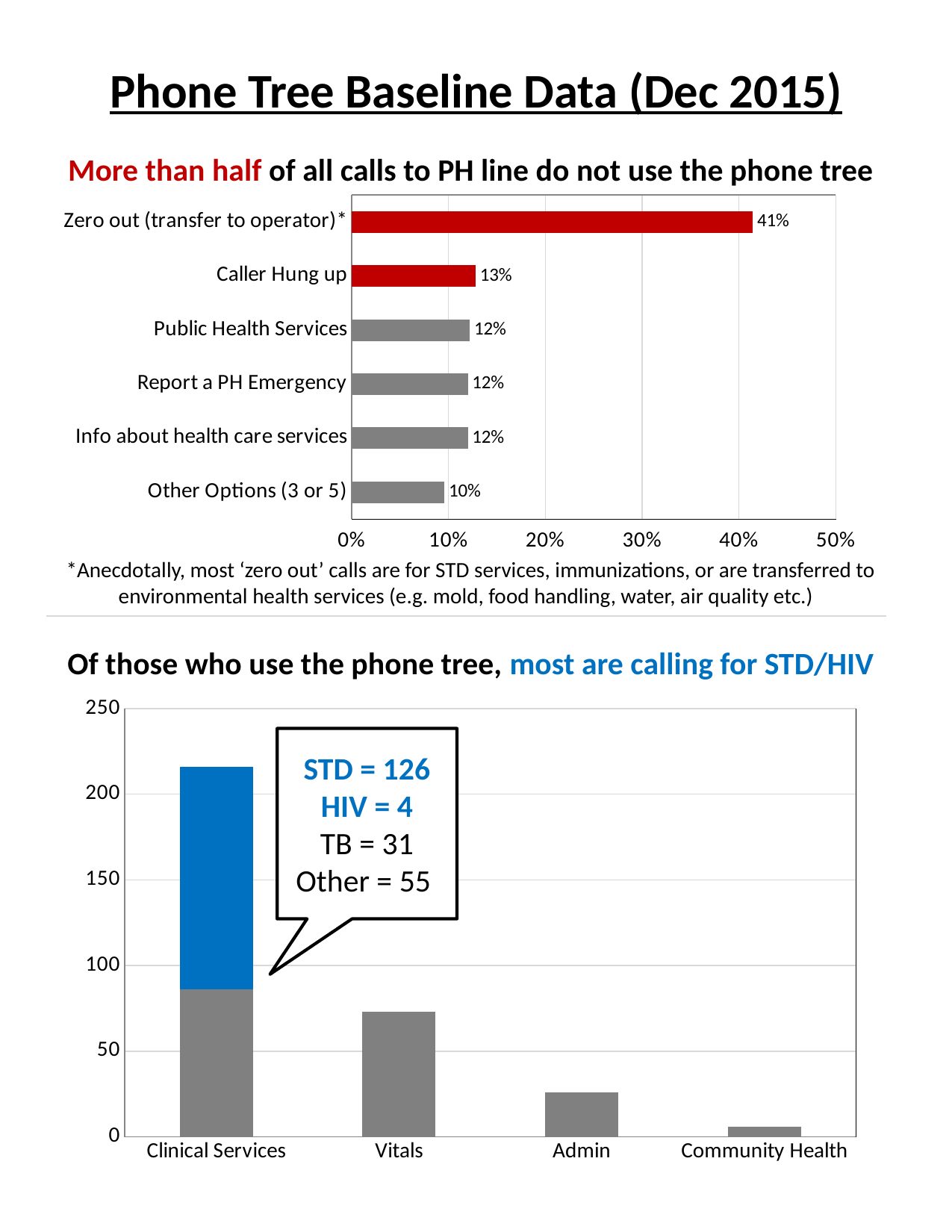
In the top chart, which category has the highest percentage? Zero out (transfer to operator) In the top chart, what percentage of calls are 'Zero out (transfer to operator)'? 41% In the top chart, what is the value for 'Other Options (3 or 5)'? 10% What type of chart is the top chart? Bar chart In the top chart, what is the value for 'Caller Hung up'? 13% In the top chart, how many categories are shown? 6 In the top chart, what is the difference in percentage points between 'Zero out (transfer to operator)' and 'Caller Hung up'? 28 In the bottom chart, which category has the tallest bar? Clinical Services In the bottom chart, is the value for Vitals greater or less than 50? greater In the bottom chart, is the value for Admin greater or less than 50? less In the top chart, which category has the lowest percentage? Other Options (3 or 5) In the bottom chart, how many categories are shown on the x axis? 4